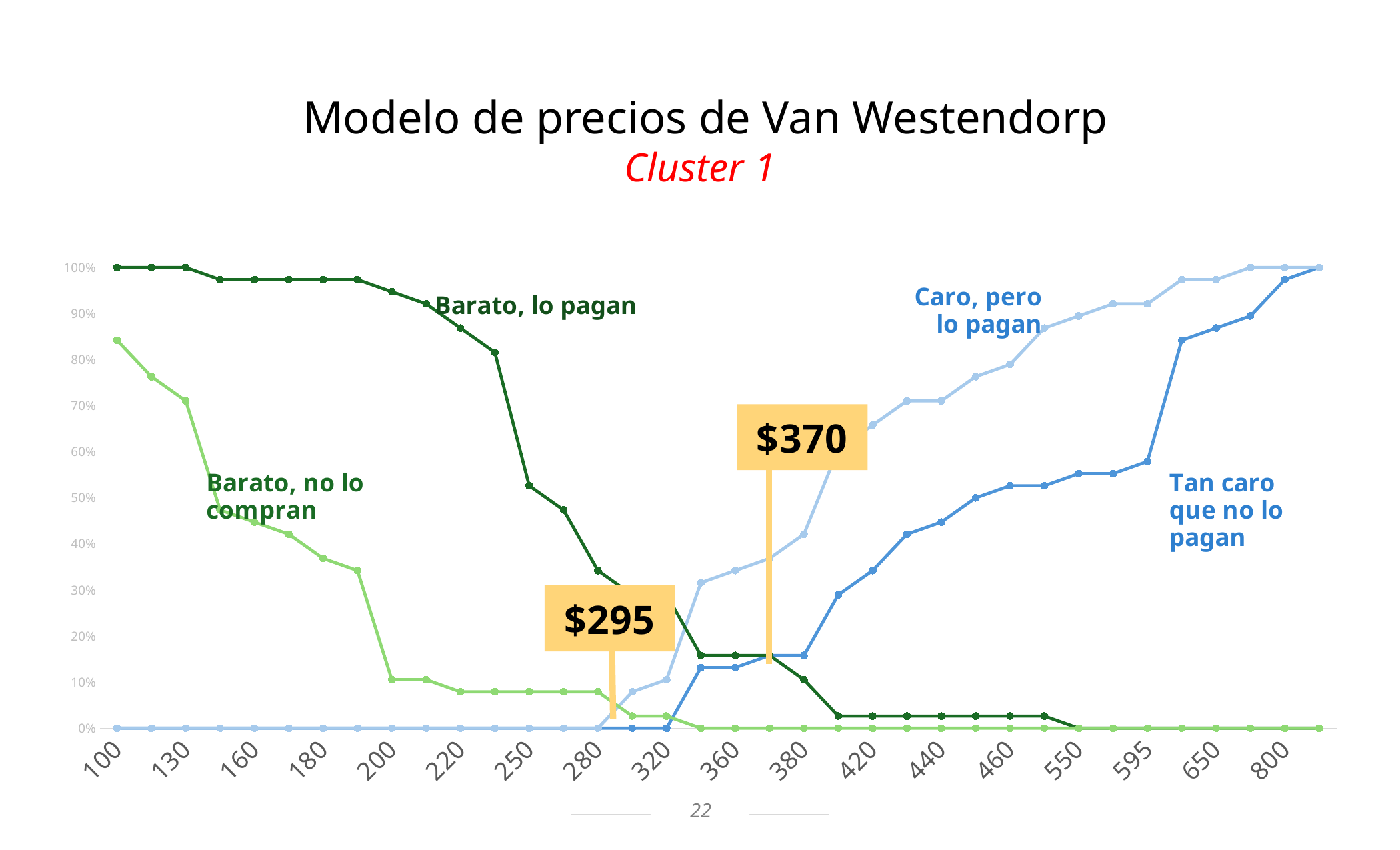
Is the value of 'Barato, lo pagan' at a price of 220 greater or less than 80%? greater Does the 'Caro, pero lo pagan' series rise or fall as price increases along the x axis? rises What is the value of the 'Barato, lo pagan' series at a price of 100? 100% How many labelled series are plotted on the chart? 4 Does the 'Barato, no lo compran' series rise or fall as price increases along the x axis? falls What is the title of the chart on the slide? Modelo de precios de Van Westendorp At a price of 460, which series has the higher value: 'Caro, pero lo pagan' or 'Tan caro que no lo pagan'? Caro, pero lo pagan Is the value of 'Barato, no lo compran' at a price of 100 greater or less than 80%? greater Is the value of 'Tan caro que no lo pagan' at a price of 595 greater or less than 70%? less What is the value of the 'Tan caro que no lo pagan' series at a price of 100? 0% What kind of chart is shown on the slide? line chart Which cluster does the subtitle say the chart refers to? Cluster 1